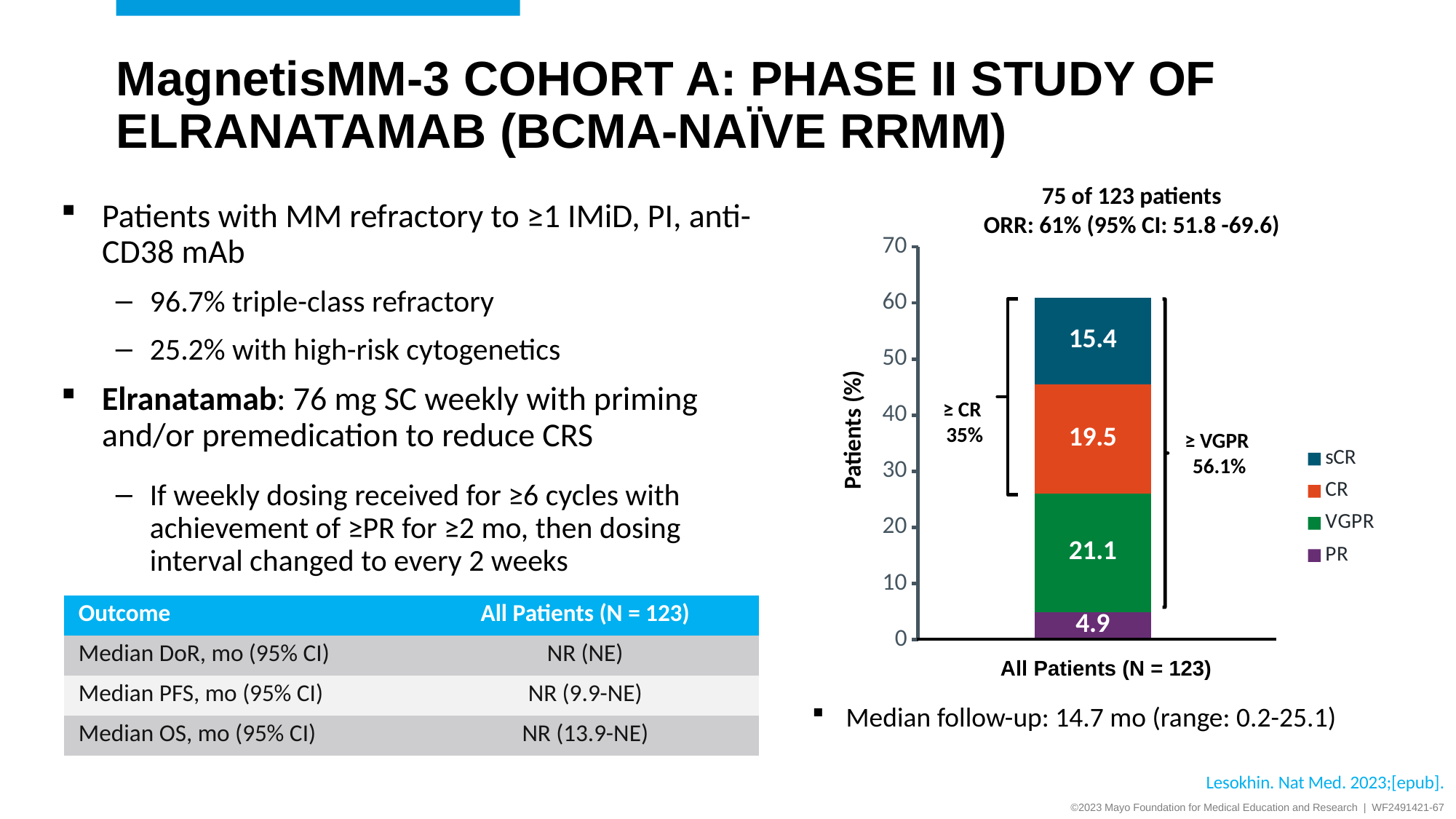
Which response category has the largest segment in the stacked bar? VGPR What is the value of the VGPR segment in the stacked bar? 21.1 What is the difference between the CR and sCR segment values? 4.1 What is the value of the CR segment in the stacked bar? 19.5 What is the total of the stacked bar for All Patients (N = 123)? 60.9 What kind of chart is shown on the slide? Stacked bar chart What is the label on the y axis of the chart? Patients (%) How many series does the legend list? 4 Which segment is larger, VGPR or CR? VGPR Which response category has the smallest segment in the stacked bar? PR What is the value of the PR segment in the stacked bar? 4.9 What is the value of the sCR segment in the stacked bar? 15.4